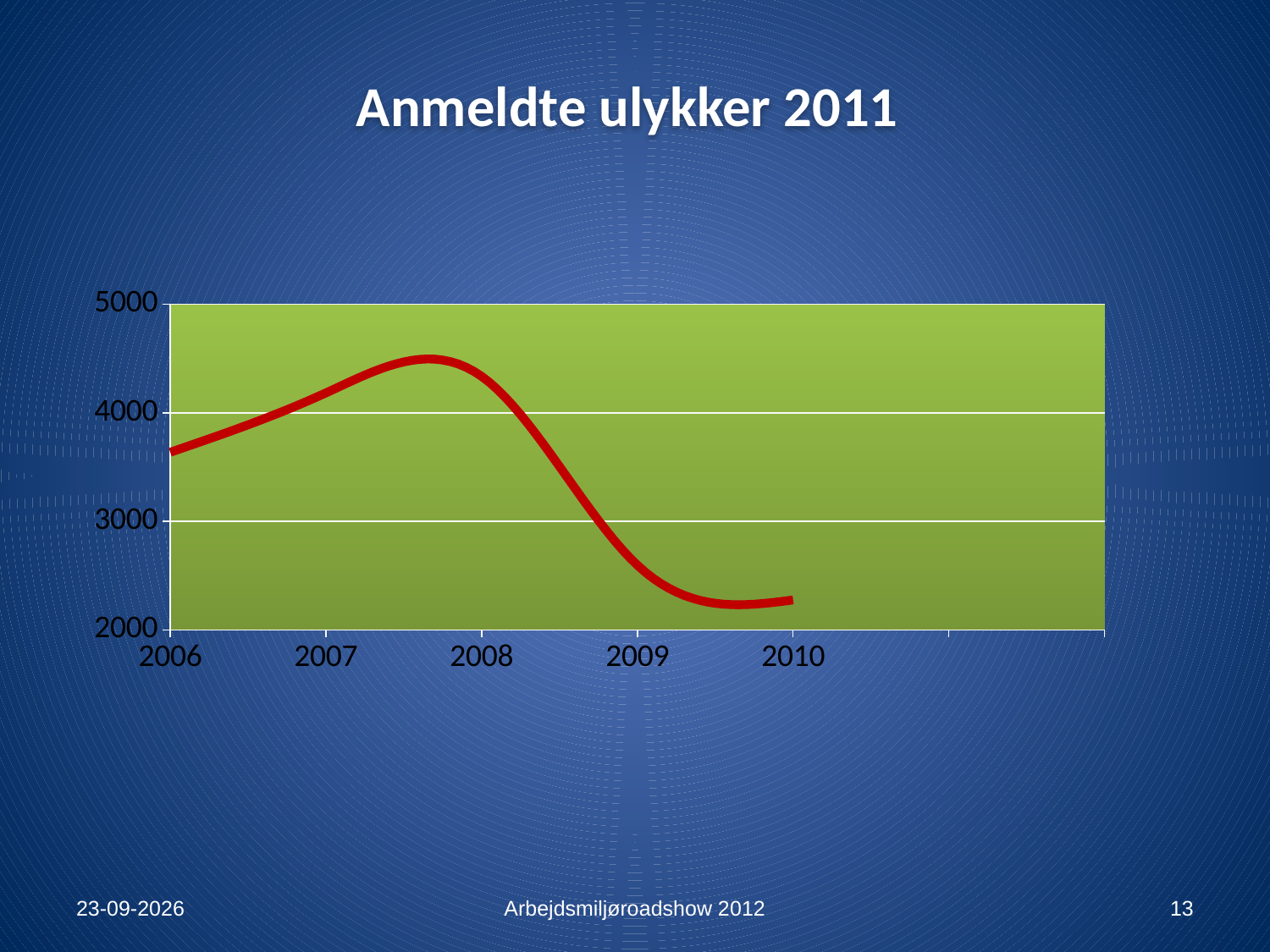
Which is larger, the value for 2007 or the value for 2009? 2007 How many years are labelled on the x axis of the chart? 5 Is the value for 2010 greater or less than 3000? less What is the title of the chart? Anmeldte ulykker 2011 Which year has the highest value on the line? 2008 Do the values rise or fall from 2008 to 2010? fall What kind of chart is shown on the slide? line chart Is the value for 2006 greater or less than 4000? less Is the value for 2006 greater or less than 3000? greater What colour is the line in the chart? red